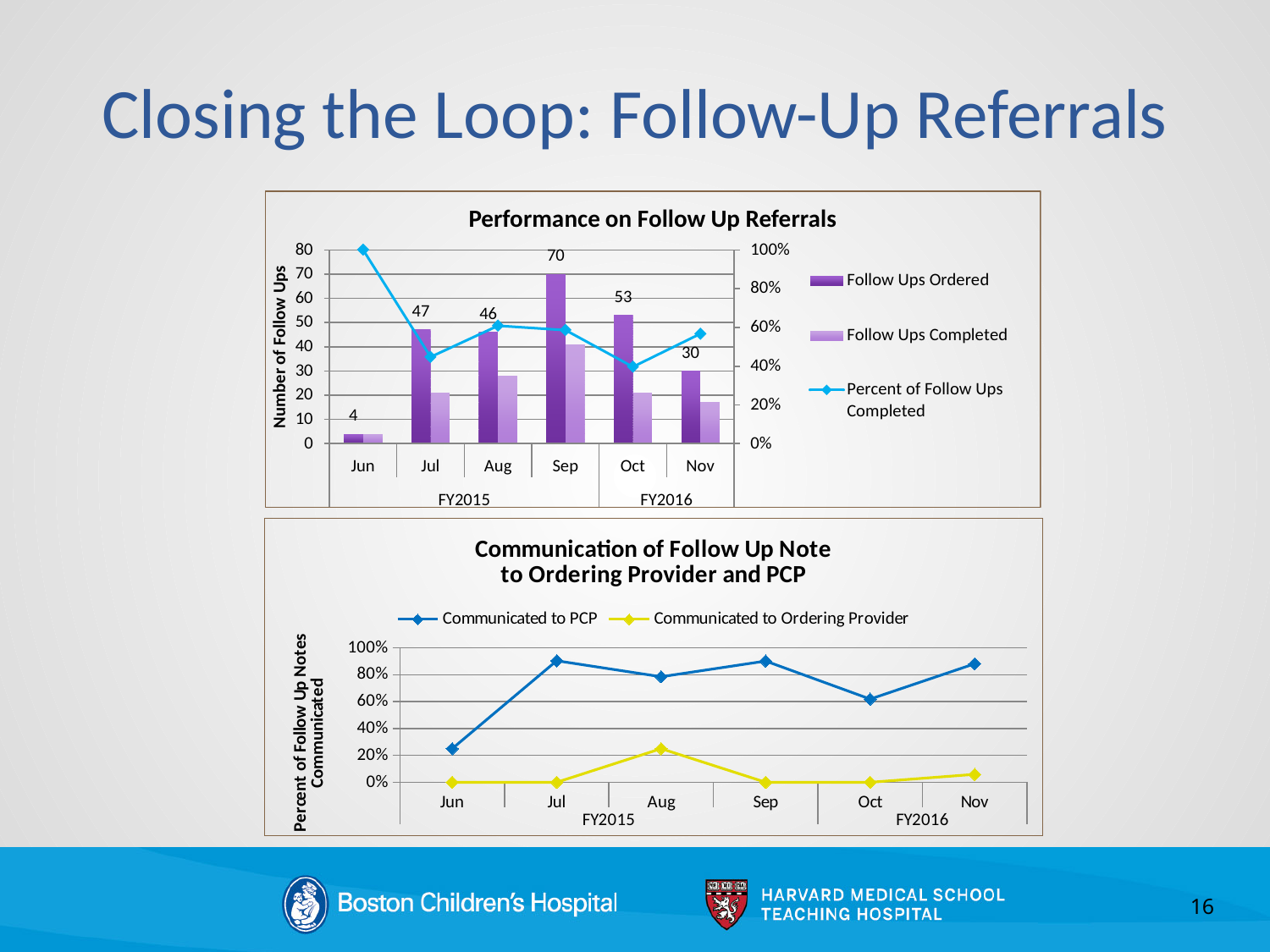
In the 'Performance on Follow Up Referrals' chart, which month has the highest number of follow ups ordered? Sep In the 'Performance on Follow Up Referrals' chart, how many months are shown on the x axis? 6 In the 'Performance on Follow Up Referrals' chart, is the number of follow ups completed in Sep greater or less than 30? greater In the 'Communication of Follow Up Note to Ordering Provider and PCP' chart, which series has the higher value in Jul, Communicated to PCP or Communicated to Ordering Provider? Communicated to PCP In the 'Performance on Follow Up Referrals' chart, what is the difference between follow ups ordered in Sep and in Oct? 17 In the 'Performance on Follow Up Referrals' chart, were more follow ups ordered in Jul or in Nov? Jul In the 'Performance on Follow Up Referrals' chart, which month has the lowest number of follow ups ordered? Jun In the 'Performance on Follow Up Referrals' chart, how many series does the legend list? 3 In the 'Performance on Follow Up Referrals' chart, how many follow ups were ordered in Sep? 70 What type of chart is the 'Communication of Follow Up Note to Ordering Provider and PCP' chart? Line chart In the 'Performance on Follow Up Referrals' chart, how many follow ups were ordered in Jun? 4 In the 'Communication of Follow Up Note to Ordering Provider and PCP' chart, is the value for Communicated to PCP in Jun greater or less than 40%? less